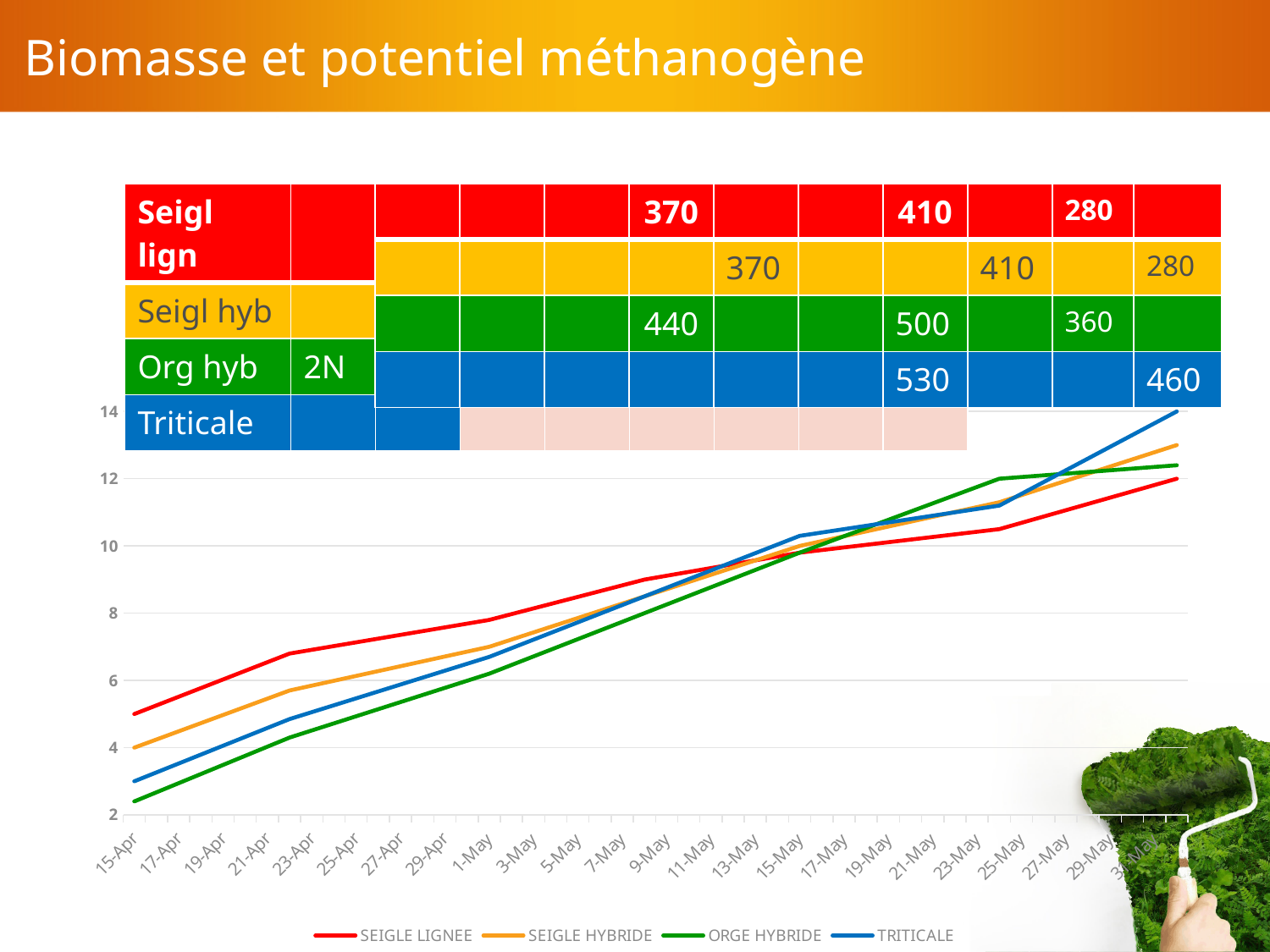
Do the values of the SEIGLE LIGNEE series rise or fall from 15-Apr to 31-May? rise Which series has the highest value at 31-May? TRITICALE Which series has the highest value at 15-Apr? SEIGLE LIGNEE Which series has the lowest value at 15-Apr? ORGE HYBRIDE Is the value for SEIGLE LIGNEE at 15-Apr greater or less than 4? greater Which series are listed in the chart legend? SEIGLE LIGNEE, SEIGLE HYBRIDE, ORGE HYBRIDE, TRITICALE What kind of chart is shown on the slide? line chart What colour is the TRITICALE line in the chart? blue How many series does the chart legend list? 4 Is the value for ORGE HYBRIDE at 15-Apr greater or less than 4? less Do the values of the ORGE HYBRIDE series rise or fall along the x axis? rise At 31-May, which is larger: the value for TRITICALE or the value for SEIGLE LIGNEE? TRITICALE